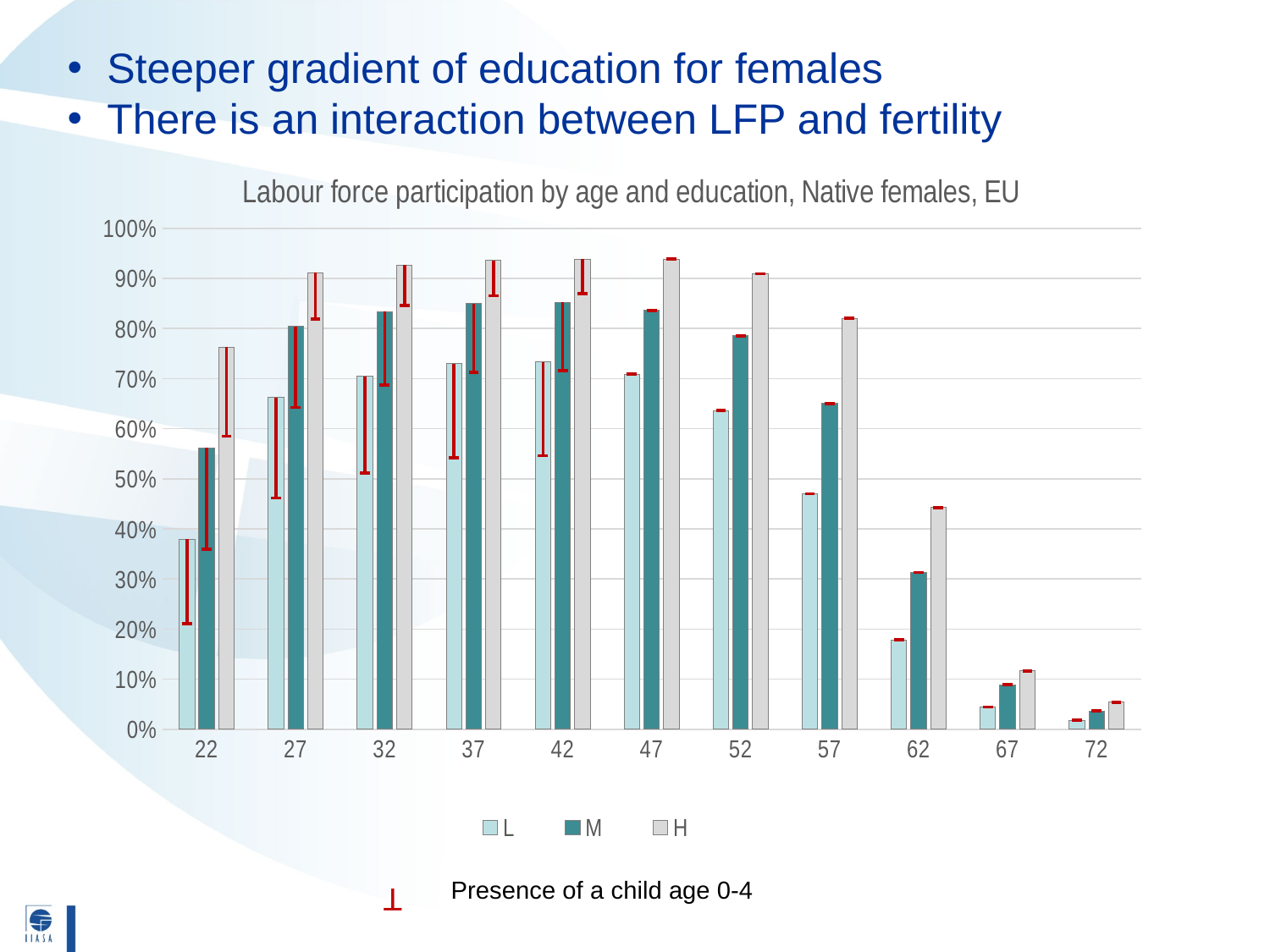
How many age groups are shown on the x axis? 11 At age 22, which is larger, the value for L or the value for H? H Is the value for H at age 22 greater or less than 70%? greater What kind of chart is shown on the slide? bar chart How many series does the legend list? 3 Is the value for L at age 22 greater or less than 50%? less Do the values for the L series rise or fall from age 47 to age 72? fall Is the value for M at age 57 greater or less than 60%? greater Which age group has the lowest value for the L series? 72 What are the three legend entries? L, M, H What is the title of the chart? Labour force participation by age and education, Native females, EU